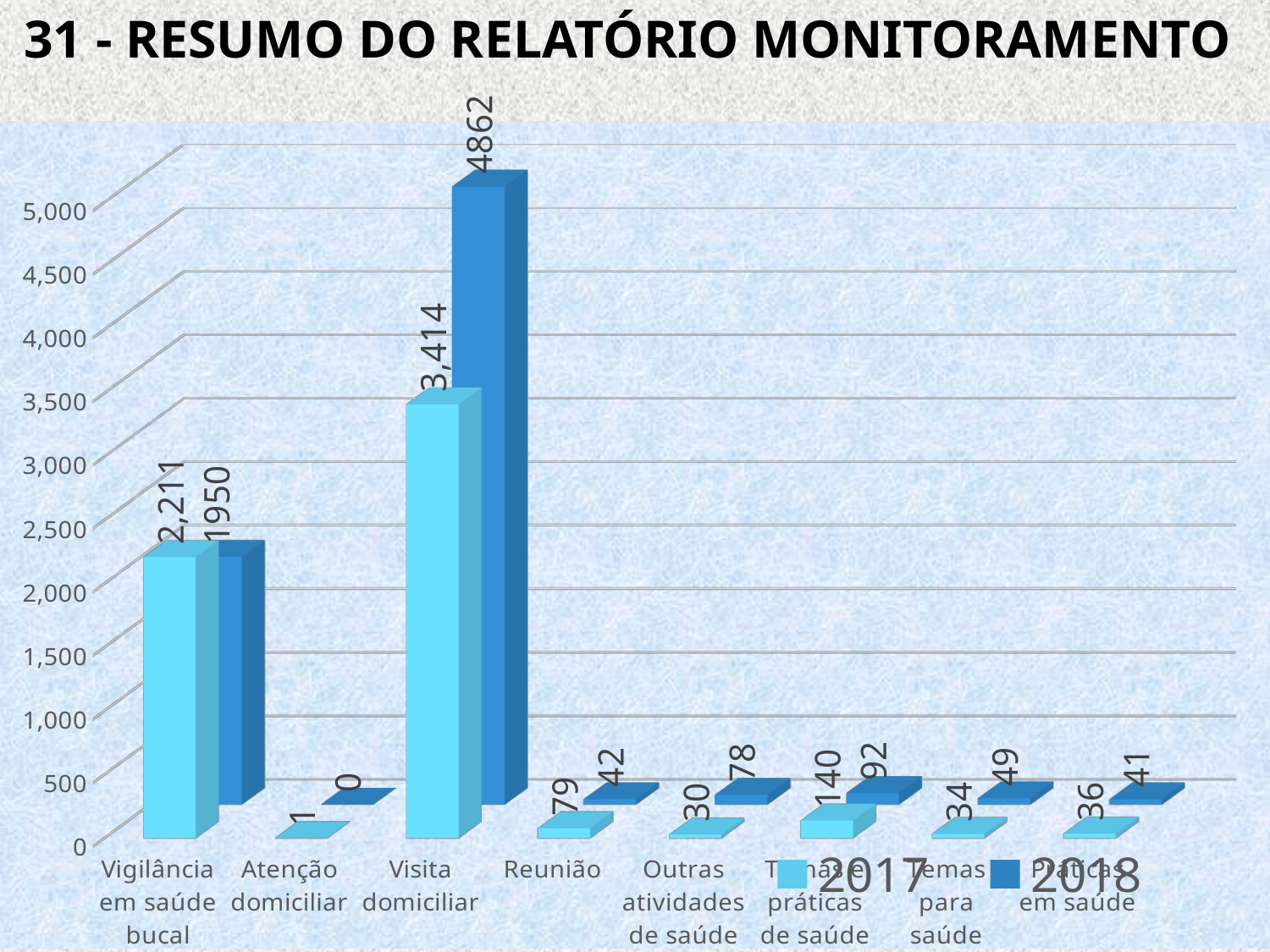
How many series does the legend list? 2 Which category has the lowest value for 2017? Atenção domiciliar Which category has the highest value for 2018? Visita domiciliar What kind of chart is shown on the slide? Bar chart For Vigilância em saúde bucal, which year has the larger value, 2017 or 2018? 2017 What is the 2018 value for Outras atividades de saúde? 78 What is the 2018 value for Visita domiciliar? 4862 What is the 2017 value for Vigilância em saúde bucal? 2,211 How many categories are shown on the x axis? 8 What is the 2017 value for Reunião? 79 How much larger is the 2018 value than the 2017 value for Visita domiciliar? 1448 What is the 2018 value for Atenção domiciliar? 0